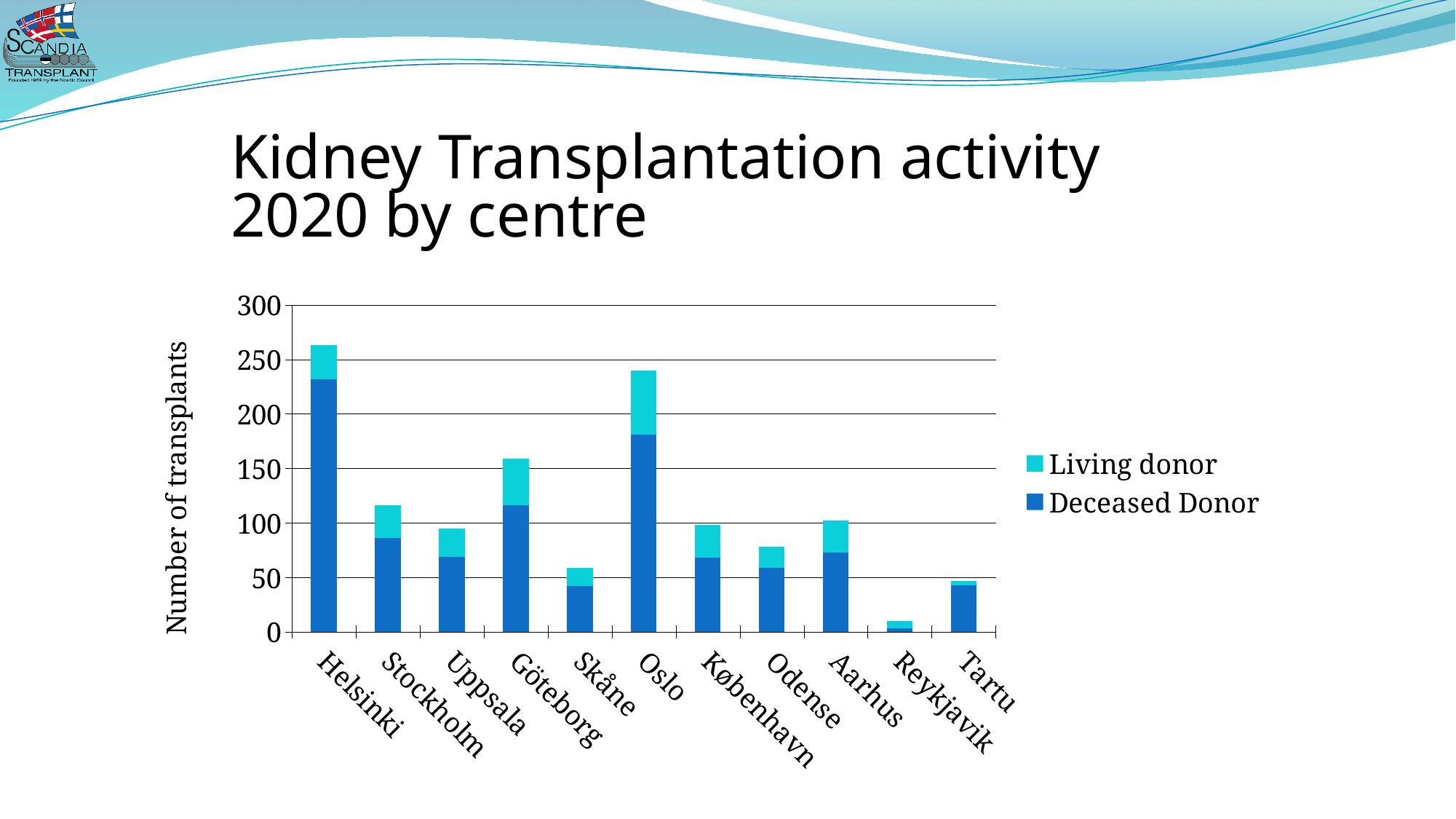
How many series does the legend list? 2 Which centre has more total transplants, Göteborg or Stockholm? Göteborg Is the total number of transplants for Helsinki greater or less than 250? greater What is the label of the y axis? Number of transplants Is the total number of transplants for Oslo greater or less than 250? less Is the total number of transplants for Odense greater or less than 100? less Which centre has the lowest total number of transplants? Reykjavik Which centre has the largest Living donor segment? Oslo What kind of chart is shown on the slide? Stacked bar chart Which centre has the highest total number of transplants? Helsinki How many centres are shown on the x axis of the chart? 11